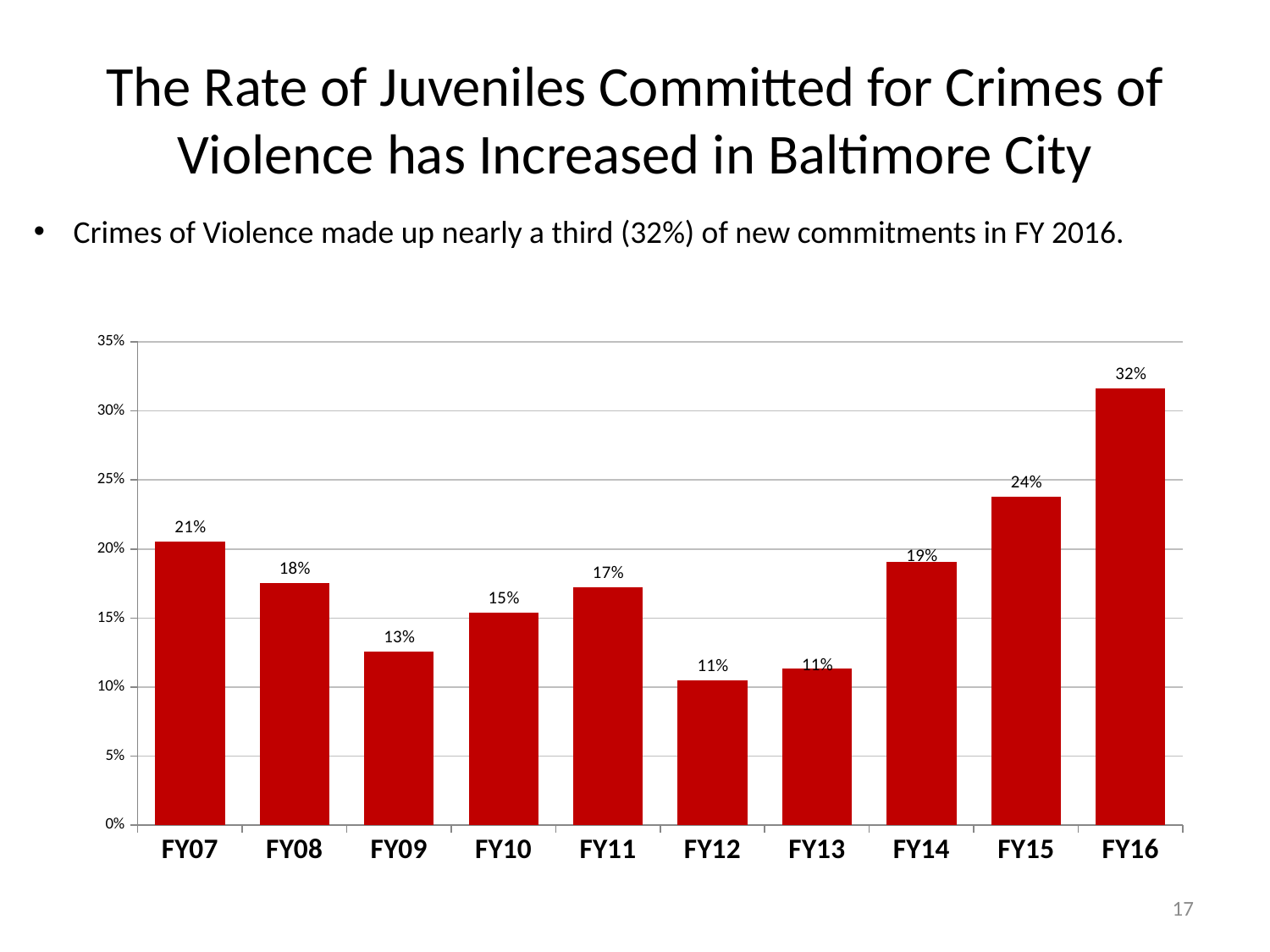
Do the values rise or fall from FY13 to FY16? rise How many fiscal years are shown on the x axis? 10 What kind of chart is shown on the slide? bar chart Which fiscal year has the highest value? FY16 Is the value for FY16 greater or less than 30%? greater What is the difference between the values for FY15 and FY14? 5 percentage points Which is larger, the value for FY07 or the value for FY08? FY07 What is the value for FY07? 21% What is the difference between the values for FY16 and FY07? 11 percentage points What is the value for FY14? 19% What is the value for FY16? 32% What is the value for FY09? 13%